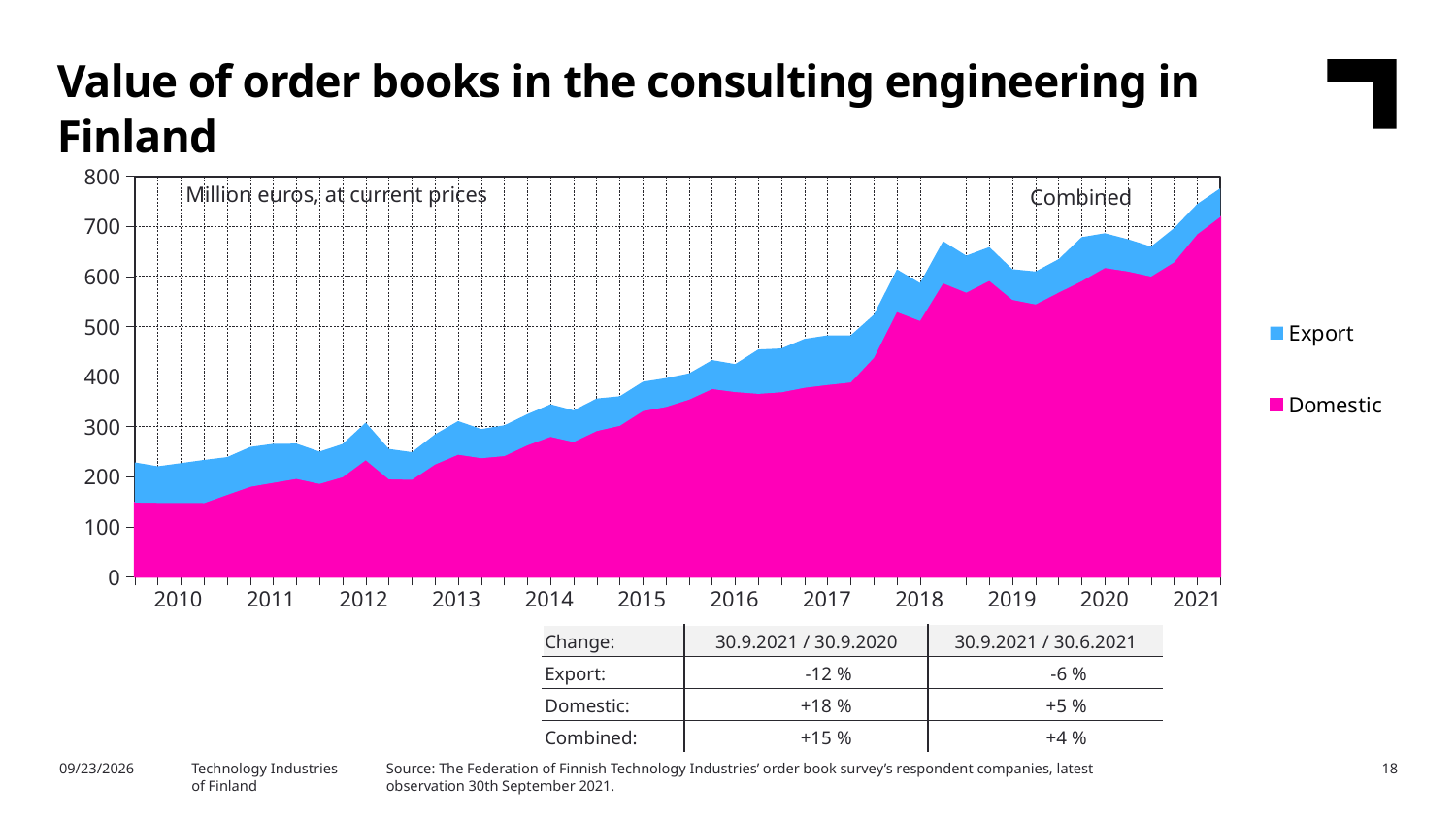
In what unit are the values on the chart expressed, according to the label inside the plot area? Million euros, at current prices In which year does the combined value reach its highest point? 2021 How many years are labelled on the x axis of the chart? 12 What are the two series named in the chart's legend? Export and Domestic Is the combined value at the end of 2021 greater or less than 700? greater Is the combined value at the start of 2010 greater or less than 300? less Does the combined value of order books rise or fall overall from 2010 to 2021? Rise How many series does the chart's legend list? 2 In 2021, which series is larger, Domestic or Export? Domestic Is the Domestic value at the end of 2021 greater or less than 600? greater What kind of chart is shown on the slide? Area chart